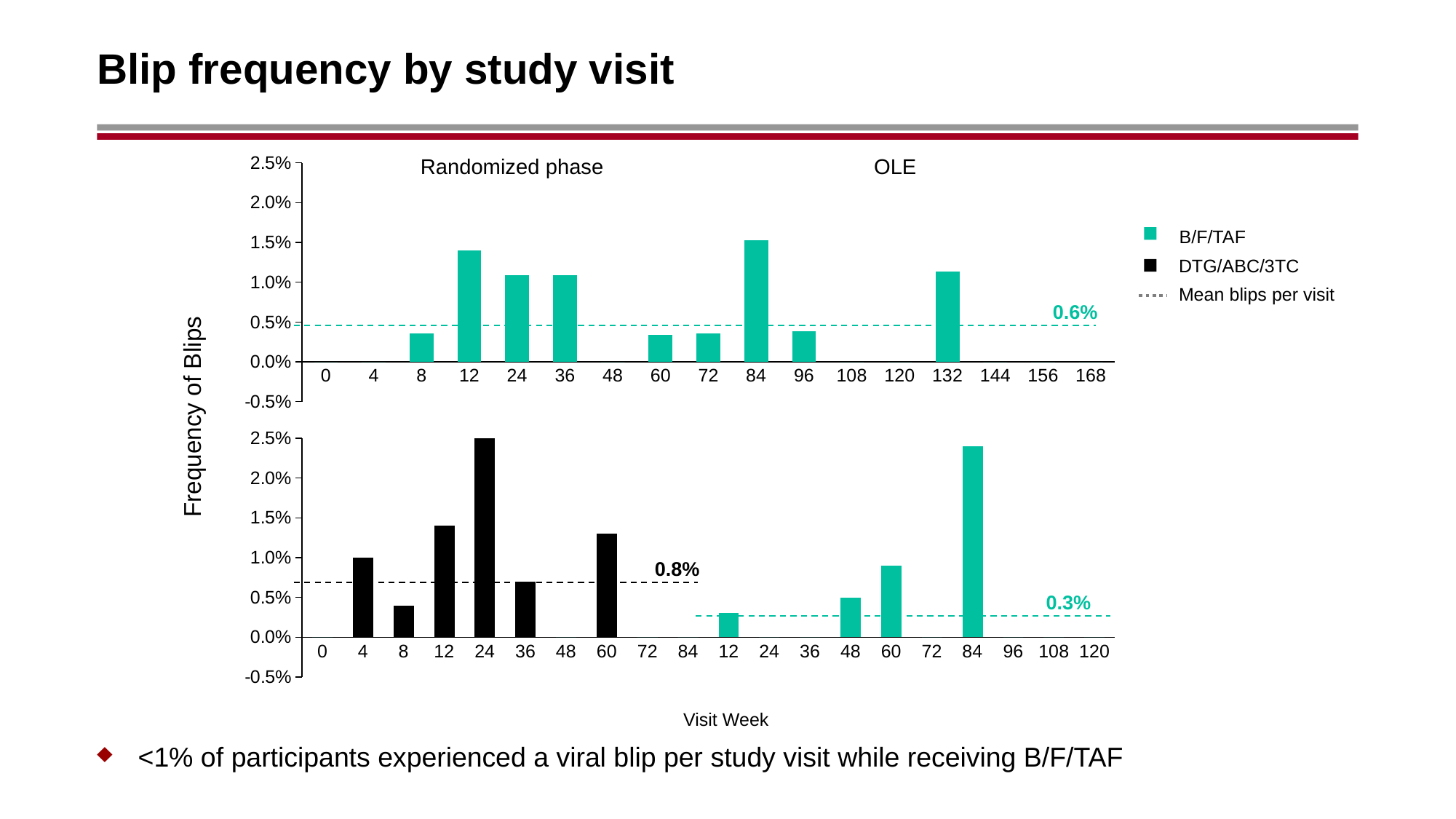
In the bottom chart, is the B/F/TAF value at OLE week 84 greater or less than 2.0%? greater In the bottom chart, what is the mean blips per visit for B/F/TAF in the OLE phase? 0.3% In the bottom chart, what is the difference between the DTG/ABC/3TC mean (0.8%) and the B/F/TAF OLE mean (0.3%)? 0.5% In the bottom chart, which has the higher mean blips per visit: DTG/ABC/3TC or B/F/TAF in the OLE? DTG/ABC/3TC How many bars are plotted in the top chart? 9 In the top chart, at which visit week is the tallest bar? 84 How many entries does the legend list? 3 In the top chart, what is the mean blips per visit value printed next to the dashed line? 0.6% In the bottom chart, what is the mean blips per visit for DTG/ABC/3TC in the randomized phase? 0.8% In the bottom chart, at which visit week is the tallest black (DTG/ABC/3TC) bar? 24 What kind of chart is shown on the slide? Bar chart In the top chart, is the value at week 12 greater or less than 1.0%? greater